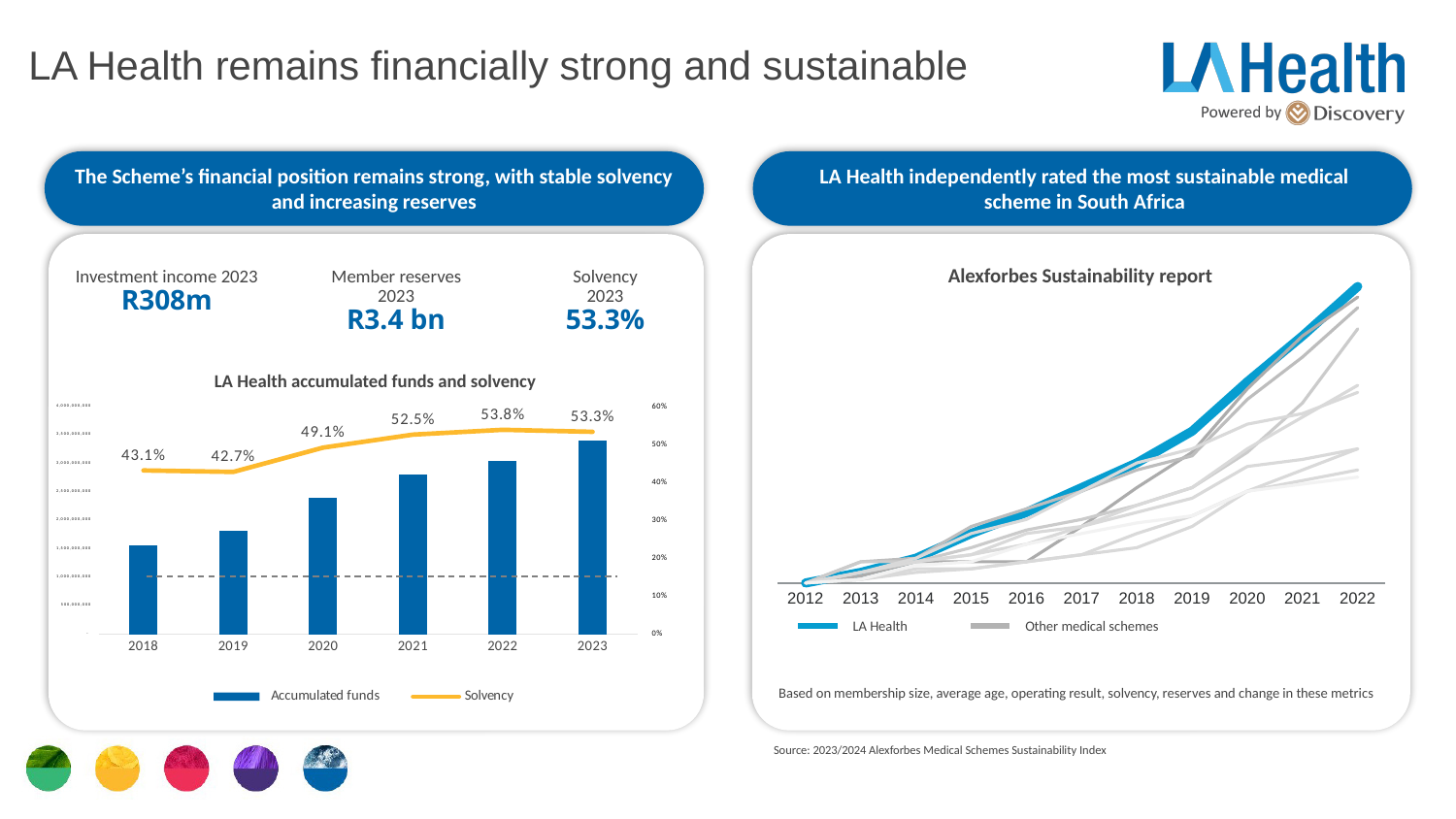
In the 'LA Health accumulated funds and solvency' chart, what is the solvency value for 2023? 53.3% In the 'Alexforbes Sustainability report' chart, how many years are shown on the x axis? 11 In the 'Alexforbes Sustainability report' chart, what kind of chart is used? line chart In the 'LA Health accumulated funds and solvency' chart, how many years are shown on the x axis? 6 In the 'LA Health accumulated funds and solvency' chart, do the accumulated funds bars rise or fall from 2018 to 2023? rise In the 'LA Health accumulated funds and solvency' chart, which year has the lowest solvency? 2019 In the 'Alexforbes Sustainability report' chart, which series is highest in 2022? LA Health In the 'LA Health accumulated funds and solvency' chart, what is the solvency value for 2020? 49.1% In the 'LA Health accumulated funds and solvency' chart, what is the difference between the solvency in 2021 and in 2018? 9.4% In the 'LA Health accumulated funds and solvency' chart, which year has the highest solvency? 2022 In the 'LA Health accumulated funds and solvency' chart, how many series does the legend list? 2 In the 'LA Health accumulated funds and solvency' chart, is the solvency higher in 2020 or in 2019? 2020